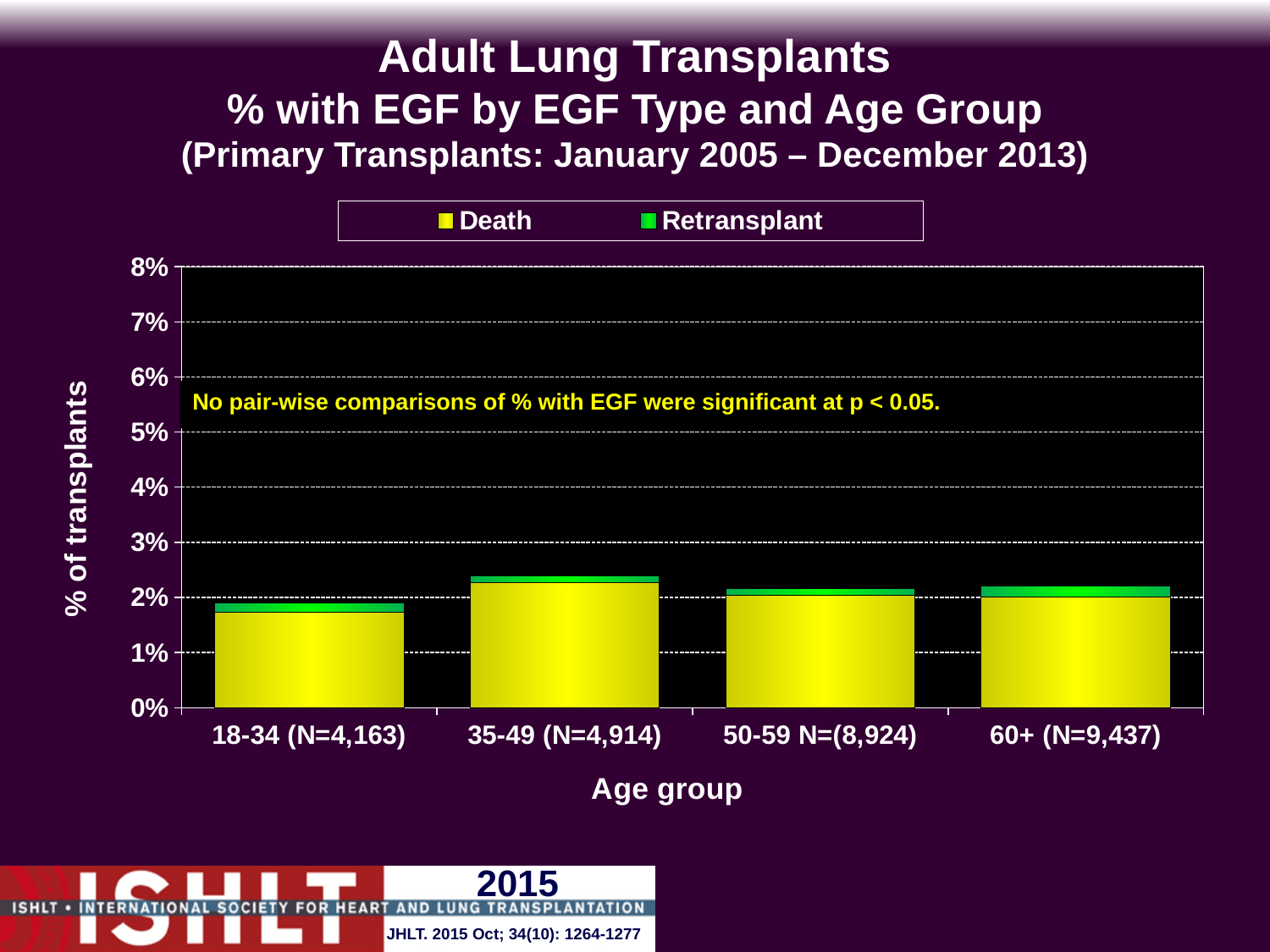
Is the total % with EGF for the 60+ age group greater or less than 3%? less Which age group has the lowest total % with EGF? 18-34 (N=4,163) What is the label on the y axis? % of transplants How many age groups are shown on the x axis? 4 Which series is shown in yellow in the legend? Death What kind of chart is shown on the slide? bar chart Is the total % with EGF for the 35-49 age group greater or less than 2%? greater Which age group has the highest total % with EGF? 35-49 (N=4,914) Which has a larger total % with EGF, the 18-34 age group or the 35-49 age group? 35-49 (N=4,914) Is the Death portion of the bar for the 50-59 age group greater or less than 1%? greater How many series does the legend list? 2